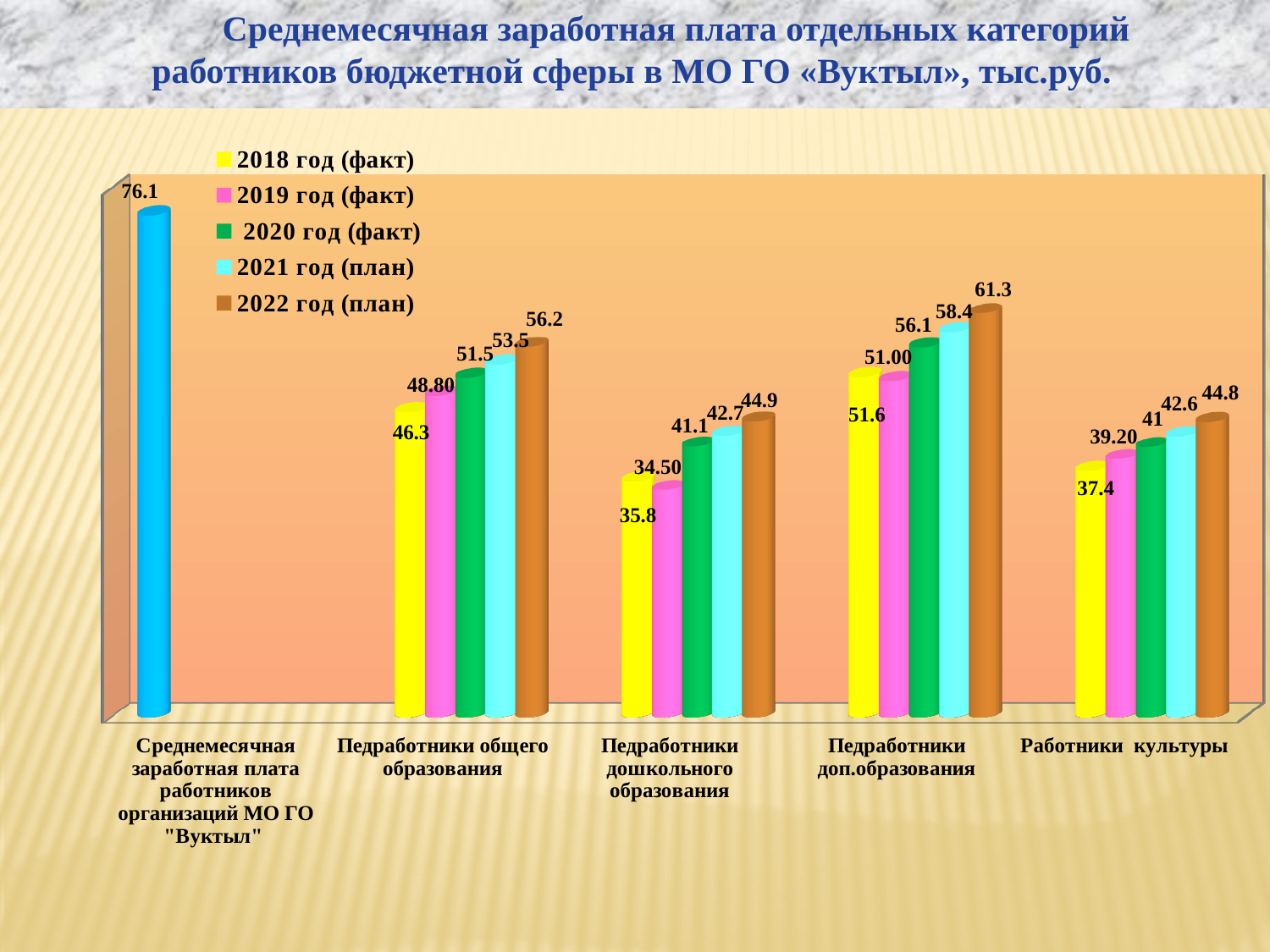
How many series does the legend list? 5 What is the value for Среднемесячная заработная плата работников организаций МО ГО "Вуктыл"? 76.1 What kind of chart is shown on the slide? bar chart Do the values for Работники культуры rise or fall from 2018 год (факт) to 2022 год (план)? rise How many categories are shown along the x axis? 5 What is the value for Педработники общего образования in 2022 год (план)? 56.2 Which is larger: the 2021 год (план) value for Педработники общего образования or for Работники культуры? Педработники общего образования Which category has the highest value for 2022 год (план)? Педработники доп.образования What is the value for Педработники дошкольного образования in 2020 год (факт)? 41.1 Which category has the lowest value for 2018 год (факт)? Педработники дошкольного образования What is the difference between the 2022 год (план) and 2018 год (факт) values for Педработники доп.образования? 9.7 What is the value for Работники культуры in 2019 год (факт)? 39.20